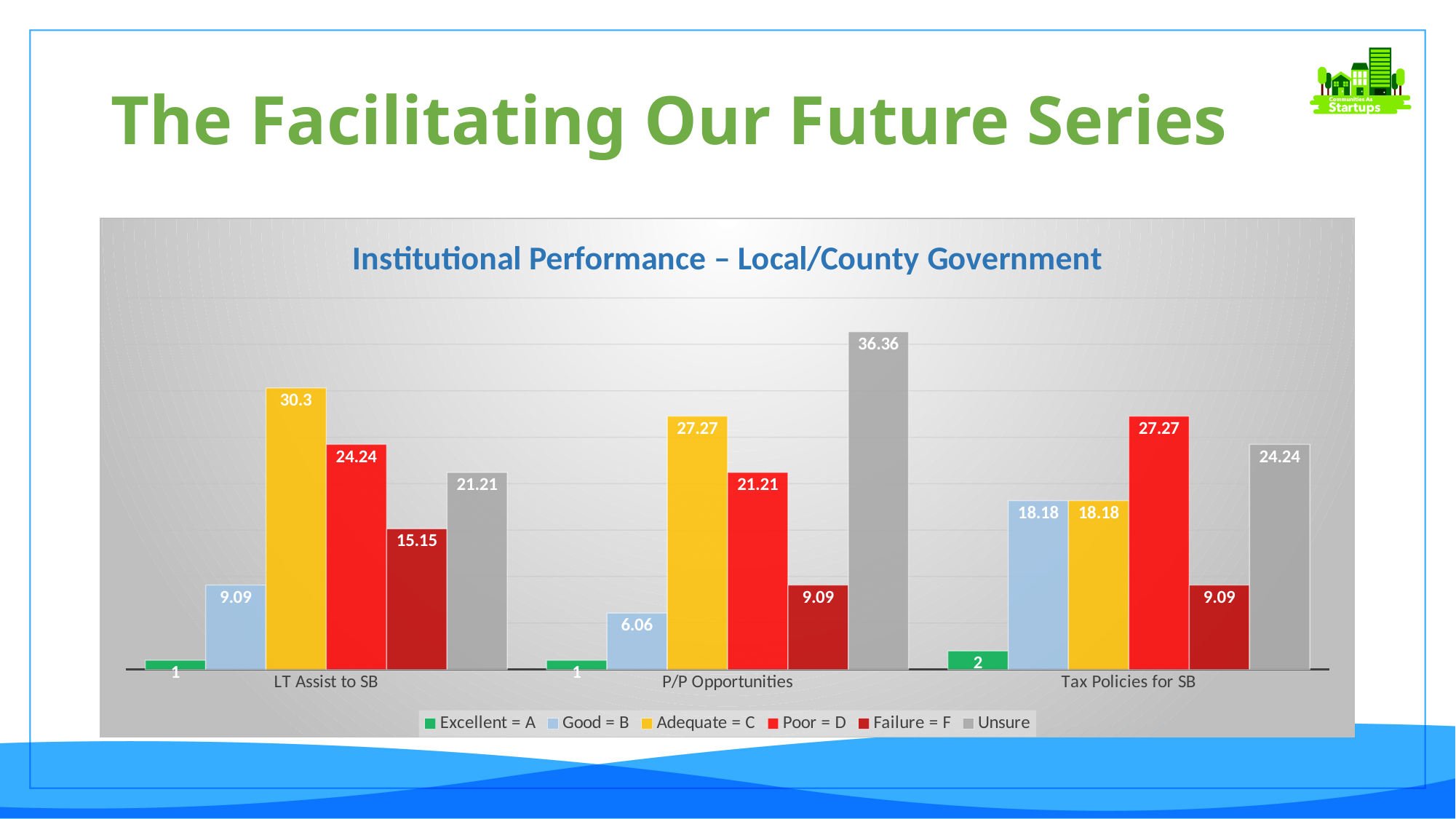
What is the value for Unsure in the P/P Opportunities category? 36.36 How many series does the legend list? 6 What kind of chart is shown on the slide? Bar chart Which is larger in the LT Assist to SB category: Poor = D or Unsure? Poor = D What is the value for Failure = F in the LT Assist to SB category? 15.15 What is the value for Good = B in the Tax Policies for SB category? 18.18 Which series has the lowest value in the Tax Policies for SB category? Excellent = A Which series has the highest value in the P/P Opportunities category? Unsure What is the title of the chart? Institutional Performance – Local/County Government What is the value for Adequate = C in the LT Assist to SB category? 30.3 How many categories are shown on the x axis? 3 What is the difference between the Poor = D and Failure = F values in the P/P Opportunities category? 12.12